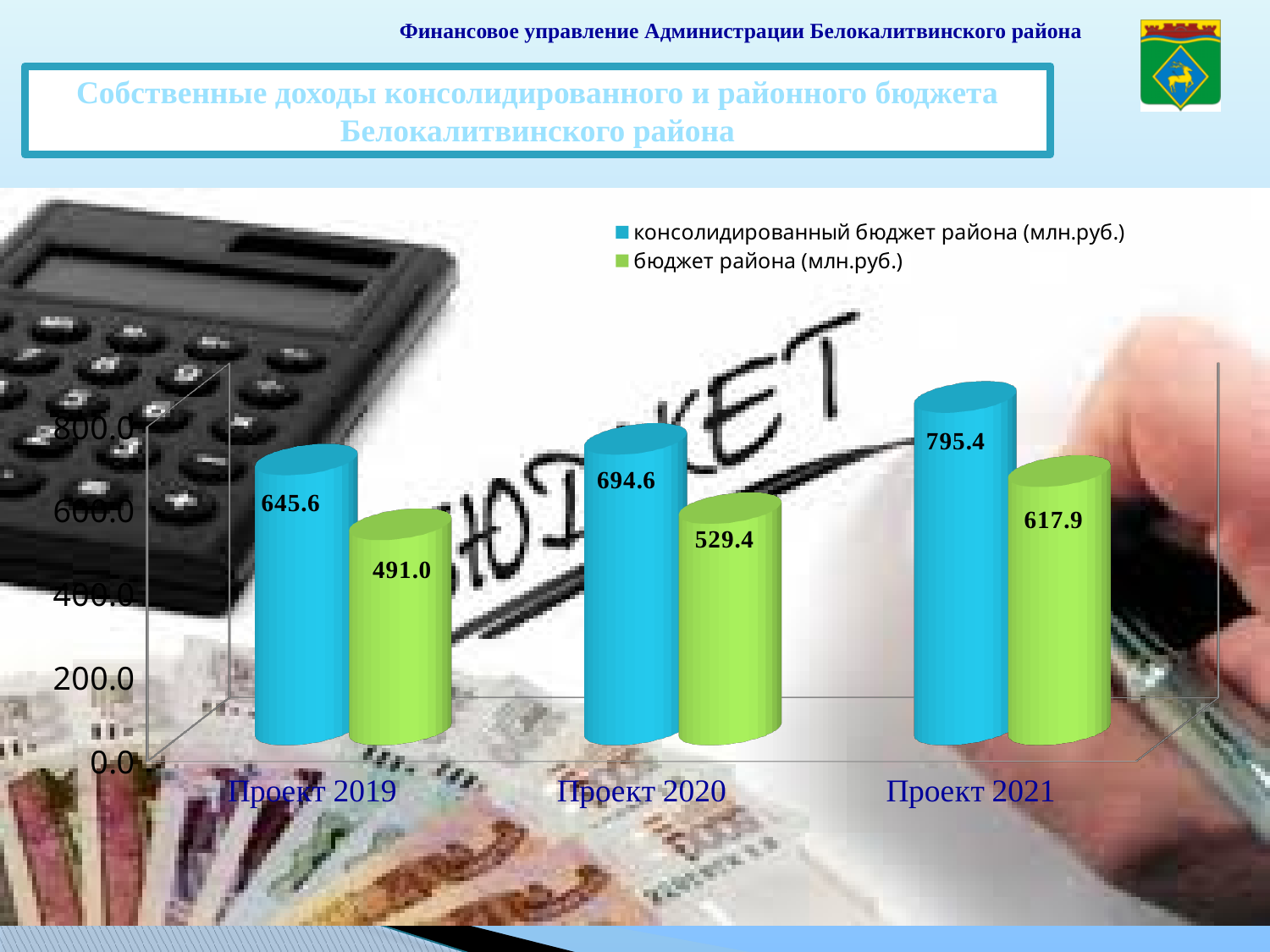
What is the value for бюджет района in Проект 2021? 617.9 What is the value for бюджет района in Проект 2020? 529.4 In which project year is консолидированный бюджет района highest? Проект 2021 What kind of chart is shown on the slide? bar chart Do the values for бюджет района rise or fall from Проект 2019 to Проект 2021? rise How many project years are shown on the x axis? 3 In which project year is бюджет района lowest? Проект 2019 What is the difference between консолидированный бюджет района and бюджет района in Проект 2021? 177.5 Which is larger: бюджет района in Проект 2020 or консолидированный бюджет района in Проект 2019? консолидированный бюджет района in Проект 2019 What is the value for консолидированный бюджет района in Проект 2019? 645.6 How many series does the legend list? 2 By how much does консолидированный бюджет района in Проект 2020 exceed that in Проект 2019? 49.0